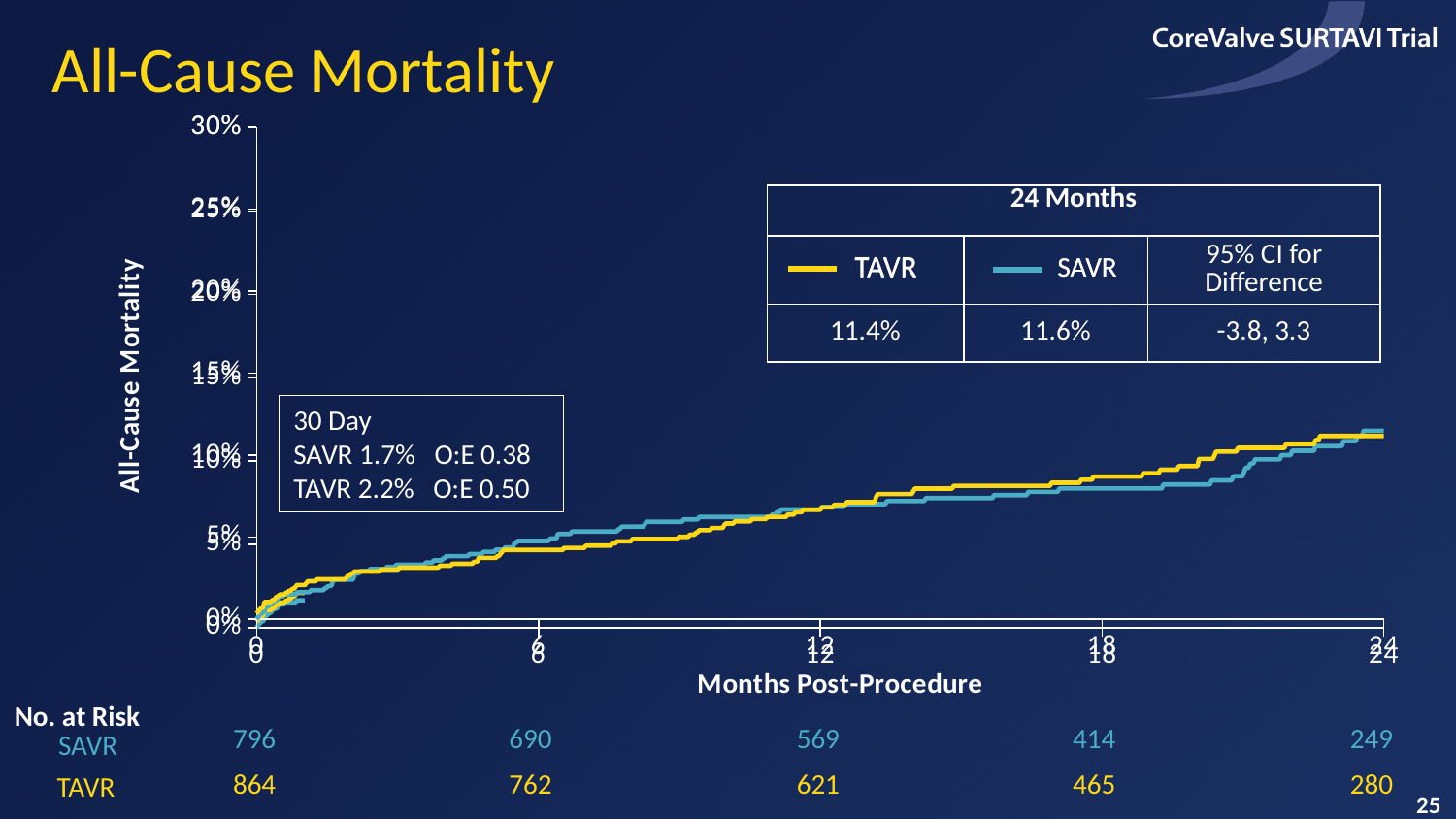
What is the 30-day all-cause mortality for TAVR? 2.2% Do the all-cause mortality curves rise or fall as months post-procedure increase? Rise How many patients were at risk in the TAVR group at 12 months? 621 How many series does the legend list? 2 What is the label of the x axis? Months Post-Procedure What is the difference between the SAVR and TAVR 30-day all-cause mortality rates? 0.5% What is the all-cause mortality for SAVR at 24 months? 11.6% Which group has the higher 30-day all-cause mortality, SAVR or TAVR? TAVR What is the all-cause mortality for TAVR at 24 months? 11.4% What kind of chart is shown on the slide? Line chart What is the 30-day all-cause mortality for SAVR? 1.7% What is the 95% CI for the difference in all-cause mortality at 24 months? -3.8, 3.3